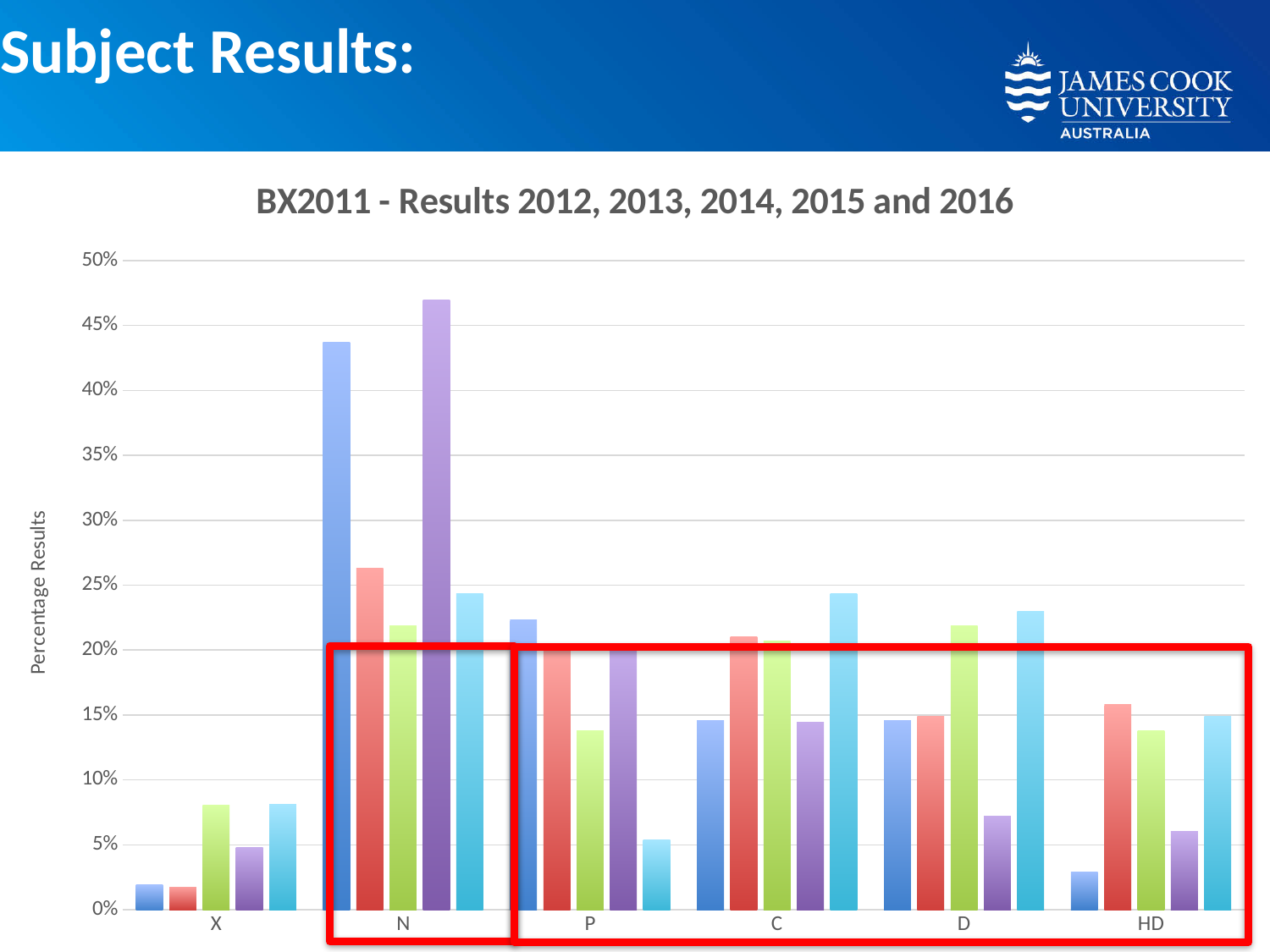
What kind of chart is shown on the slide? bar chart Which category contains the tallest bar in the chart? N Is the tallest bar in category N greater or less than 45%? greater Is the tallest bar in category HD greater or less than 20%? less What is the title of the chart? BX2011 - Results 2012, 2013, 2014, 2015 and 2016 Which category has the taller highest bar, X or HD? HD Which category contains the shortest bar in the chart? X How many bars are plotted for each category in the chart? 5 How many categories are shown along the x axis of the chart? 6 Is the tallest bar in category X greater or less than 10%? less What is the label on the vertical axis of the chart? Percentage Results